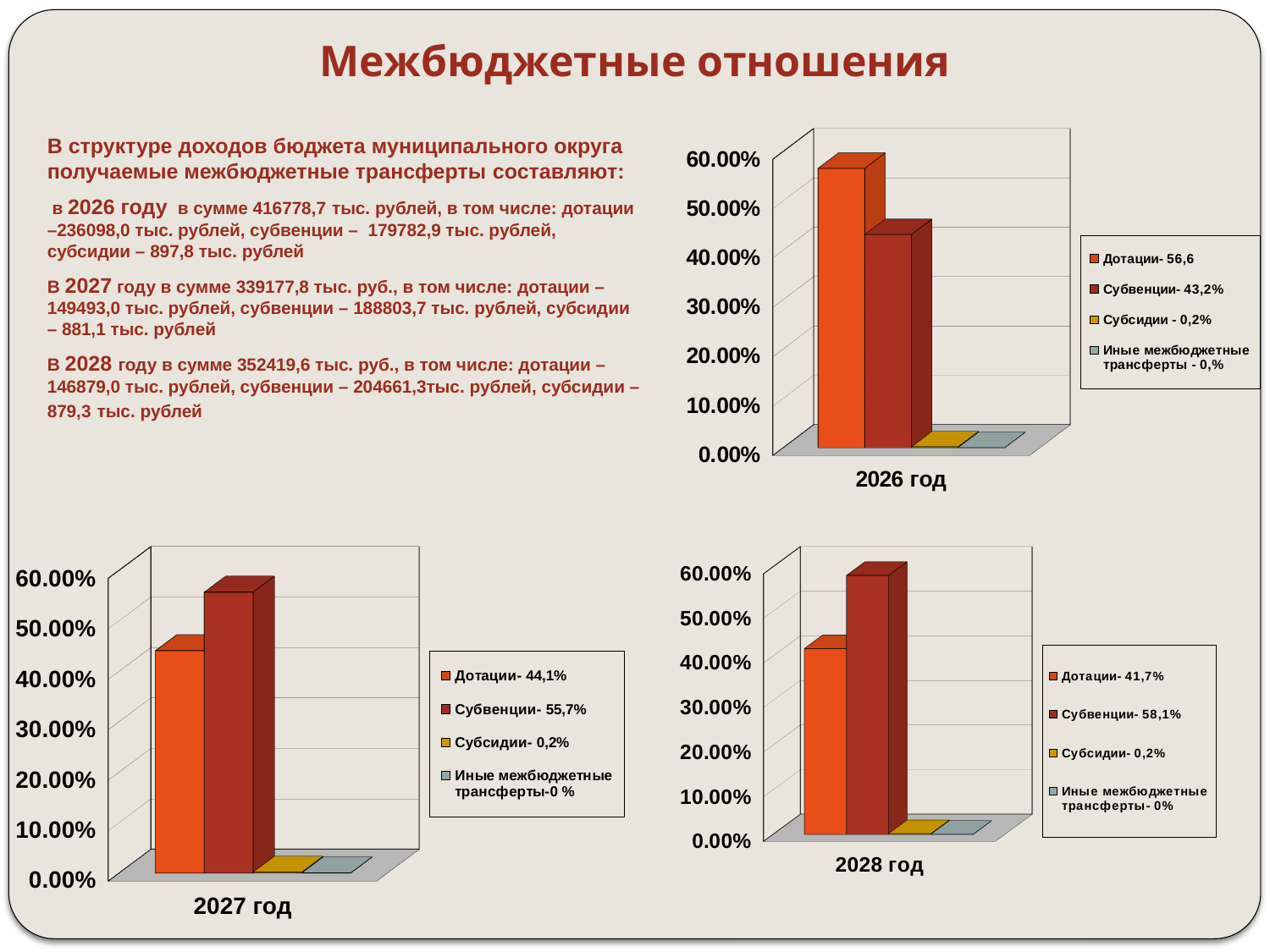
In the chart titled "2028 год", what is the difference between Субвенции (58,1%) and Дотации (41,7%)? 16,4% In the chart titled "2026 год", which category has the highest value? Дотации In the chart titled "2026 год", is the value for Субвенции greater or less than 50%? less In the chart titled "2026 год", what value does the legend give for Субвенции? 43,2% In the chart titled "2027 год", what value does the legend give for Субвенции? 55,7% What kind of chart is the chart titled "2028 год"? bar chart In the chart titled "2028 год", which category has the highest value? Субвенции In the chart titled "2027 год", which is larger, Дотации or Субвенции? Субвенции In the chart titled "2028 год", what value does the legend give for Дотации? 41,7% How many charts are shown on the slide? 3 In the chart titled "2026 год", what value does the legend give for Дотации? 56,6 How many series does the legend of the chart titled "2027 год" list? 4